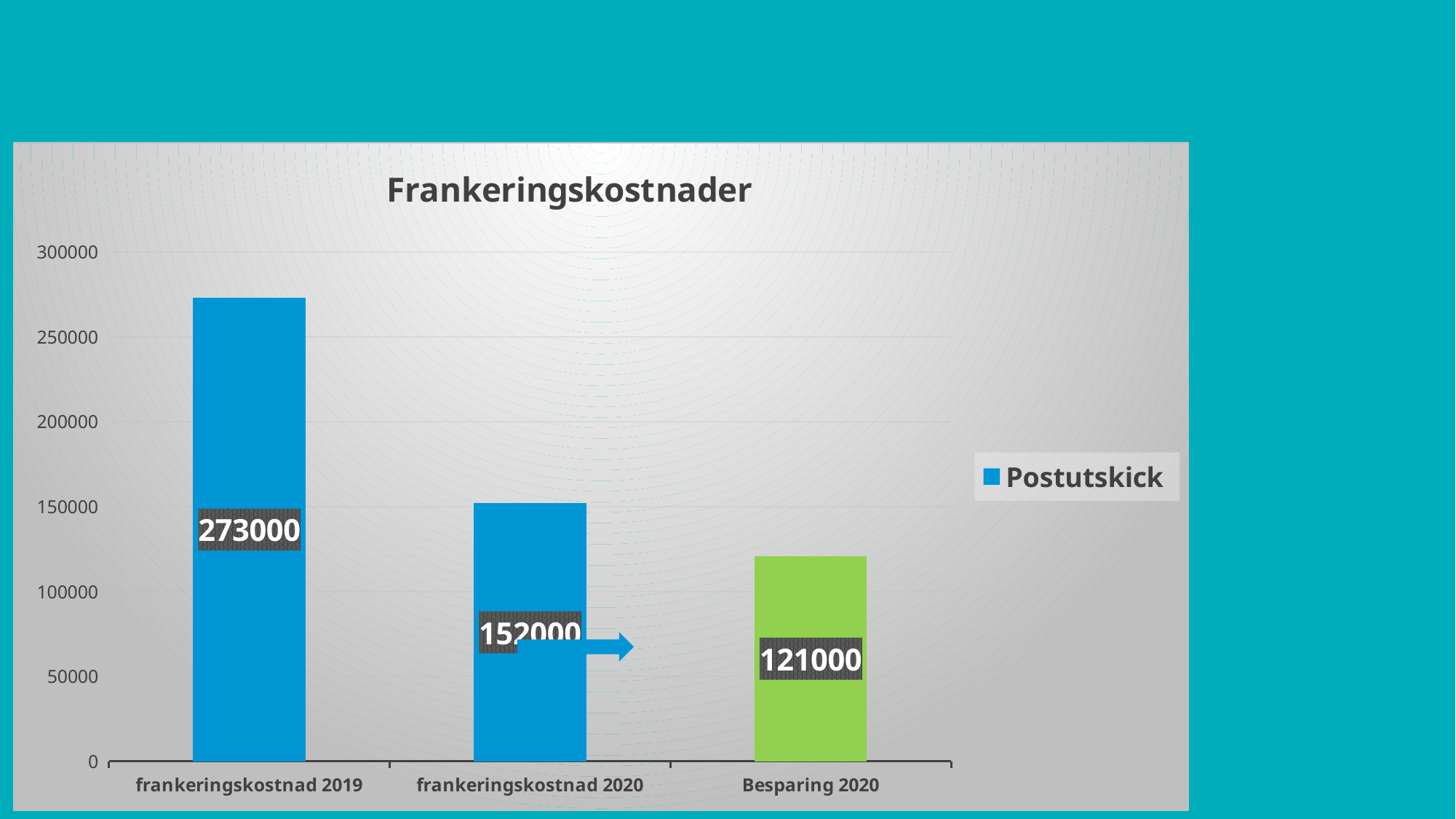
How many categories are shown on the x axis? 3 What is the title of the chart? Frankeringskostnader What is the value for Besparing 2020? 121000 What is the difference between frankeringskostnad 2019 and frankeringskostnad 2020? 121000 What is the value for frankeringskostnad 2019? 273000 Is the value for Besparing 2020 greater or less than 150000? less Which category has the lowest value? Besparing 2020 Which category has the highest value? frankeringskostnad 2019 How many series does the legend list? 1 Which is larger, frankeringskostnad 2020 or Besparing 2020? frankeringskostnad 2020 What kind of chart is shown? bar chart What is the value for frankeringskostnad 2020? 152000